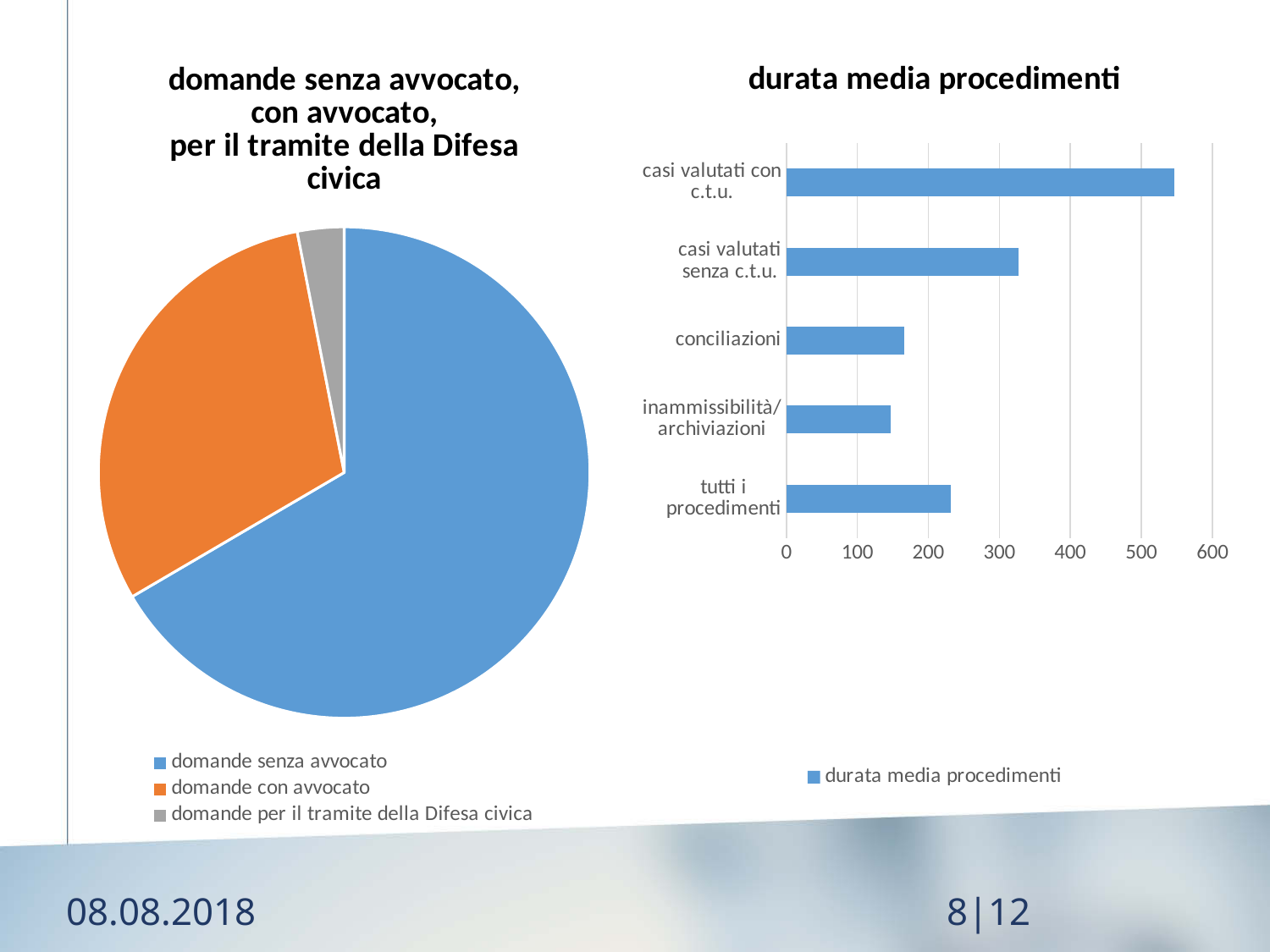
What kind of chart is the chart titled "domande senza avvocato, con avvocato, per il tramite della Difesa civica"? pie chart What kind of chart is the chart titled "durata media procedimenti"? bar chart How many categories are shown in the chart "durata media procedimenti"? 5 In the chart "durata media procedimenti", which category has the highest value? casi valutati con c.t.u. In the pie chart on the left, which category has the smallest slice? domande per il tramite della Difesa civica In the chart "durata media procedimenti", which is larger: the value for "casi valutati con c.t.u." or for "casi valutati senza c.t.u."? casi valutati con c.t.u. How many categories does the legend of the pie chart on the left list? 3 In the chart "durata media procedimenti", is the value for "conciliazioni" greater or less than 200? less In the chart "durata media procedimenti", is the value for "tutti i procedimenti" greater or less than 200? greater In the chart "durata media procedimenti", is the value for "casi valutati con c.t.u." greater or less than 500? greater In the pie chart on the left, which category has the largest slice? domande senza avvocato